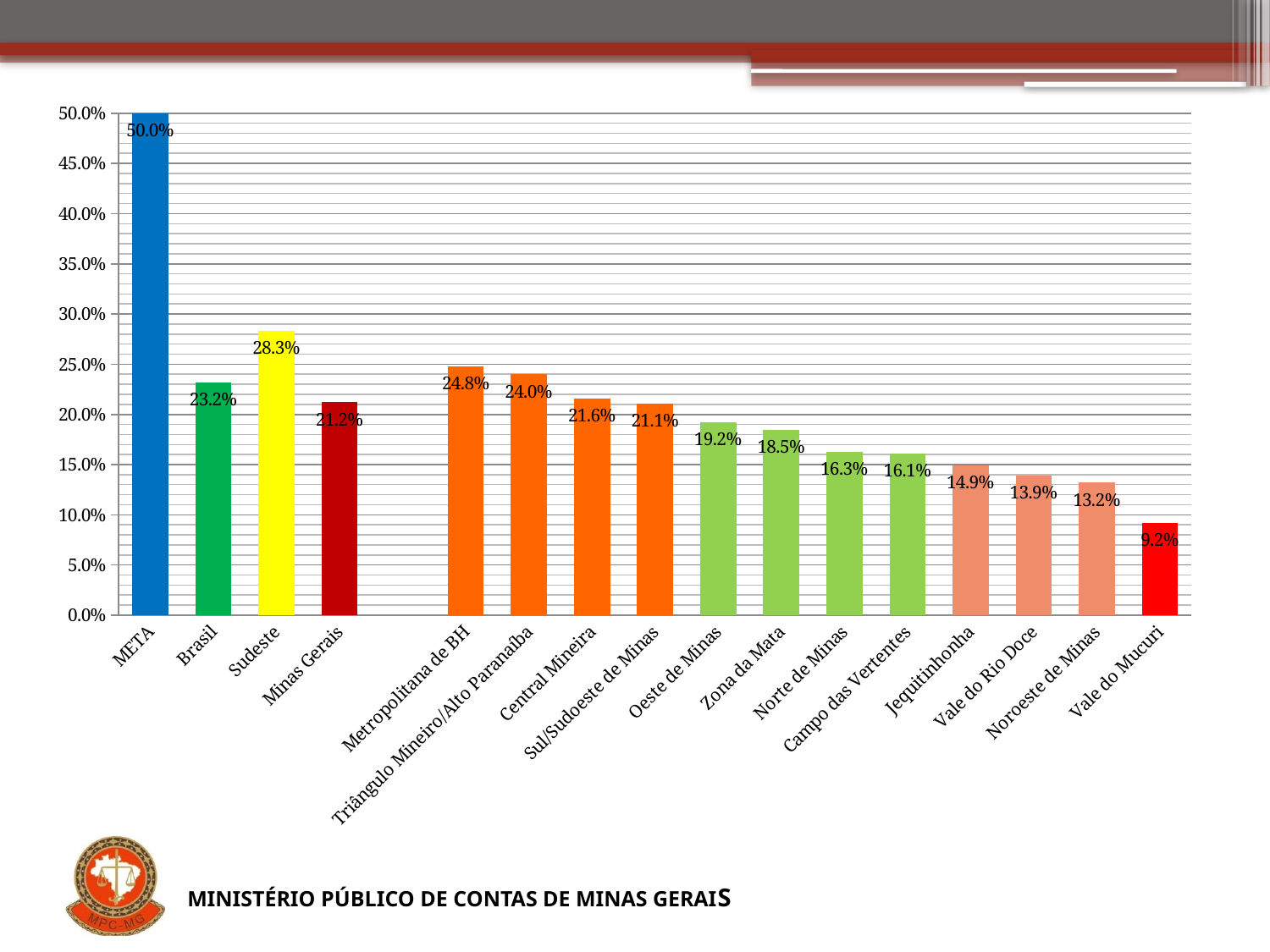
What is the value shown for Jequitinhonha? 14.9% What is the difference between the values for Sudeste and Brasil? 5.1% What is the value shown for Sudeste? 28.3% What is the value shown for Metropolitana de BH? 24.8% What kind of chart is shown on the slide? Bar chart How many categories are shown on the x axis? 16 What colour is the bar for META? Blue Which category has the lowest value? Vale do Mucuri What is the value shown for META? 50.0% What is the difference between the values for META and Minas Gerais? 28.8% Which is larger, the value for Zona da Mata or the value for Oeste de Minas? Oeste de Minas Which category has the highest value? META